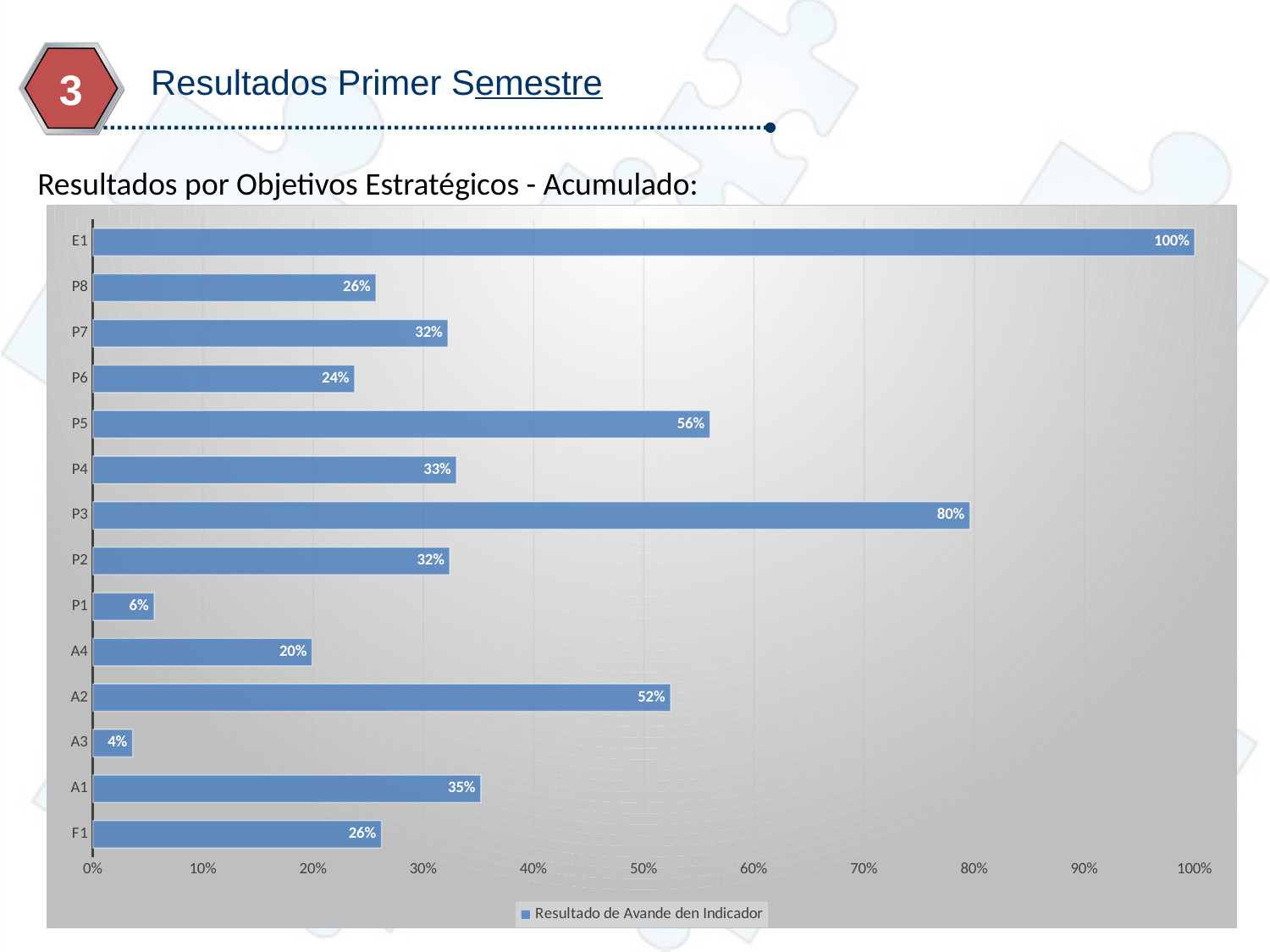
Which category has the lowest value? A3 Is the value for P7 greater or less than 40%? less What is the value for A2? 52% How many series does the legend list? 1 Which is larger, the value for A1 or the value for P4? A1 What is the value for P3? 80% What is the difference between the values for P5 and P6? 32% Which category has the highest value? E1 How many categories are shown on the chart? 14 What is the legend entry for the series shown? Resultado de Avande den Indicador What is the value for P1? 6% What kind of chart is shown on the slide? bar chart